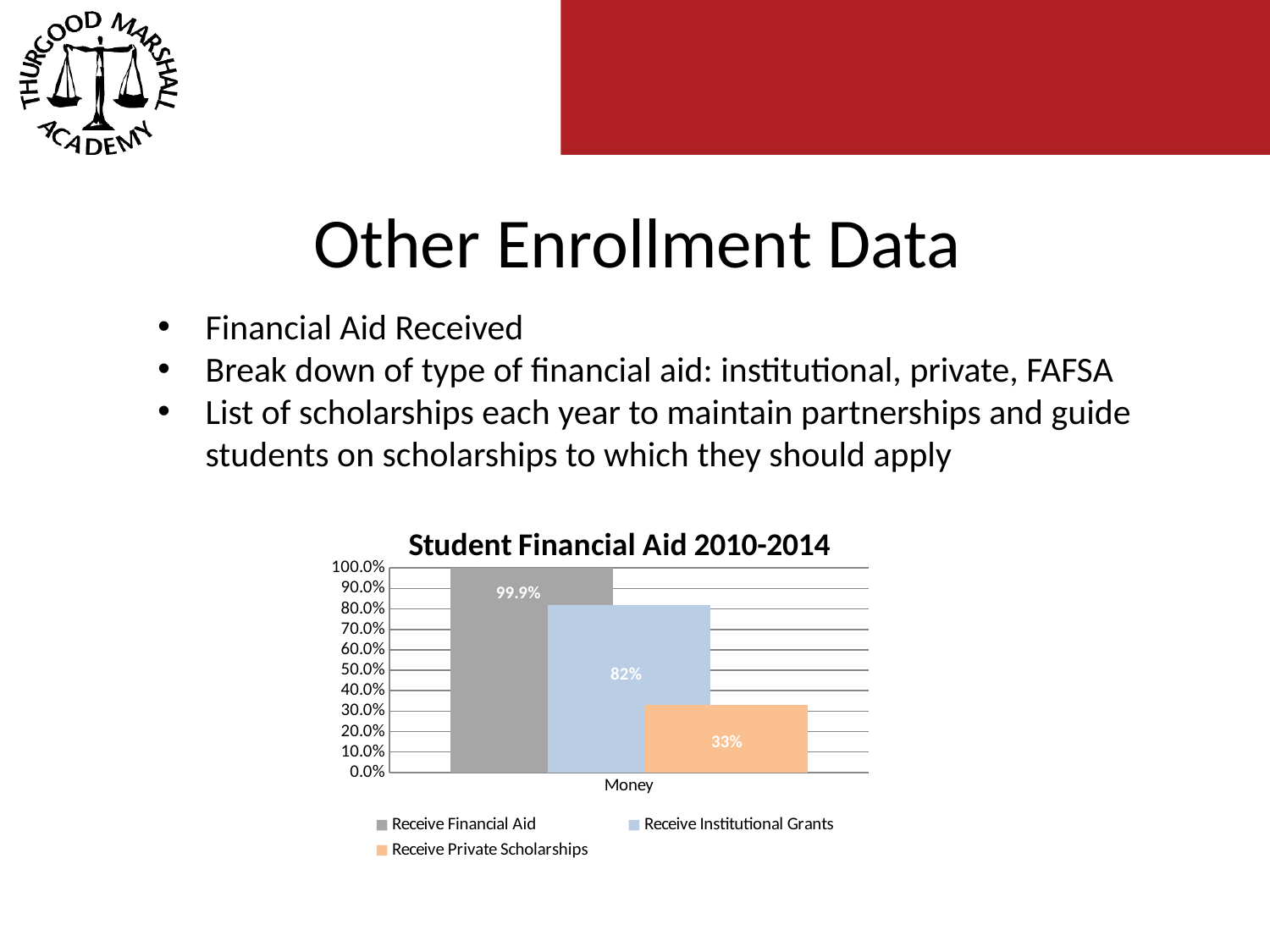
What kind of chart is shown? bar chart What is the value for Receive Institutional Grants? 82% What is the value for Receive Private Scholarships? 33% Is the value for Receive Private Scholarships greater or less than 40.0%? less Which series has the lowest value? Receive Private Scholarships How many series does the legend list? 3 What is the difference between Receive Institutional Grants and Receive Private Scholarships? 49% Which series has the highest value? Receive Financial Aid What is the category label on the x axis? Money Which is larger, Receive Financial Aid or Receive Institutional Grants? Receive Financial Aid What is the title of the chart? Student Financial Aid 2010-2014 What is the value for Receive Financial Aid? 99.9%